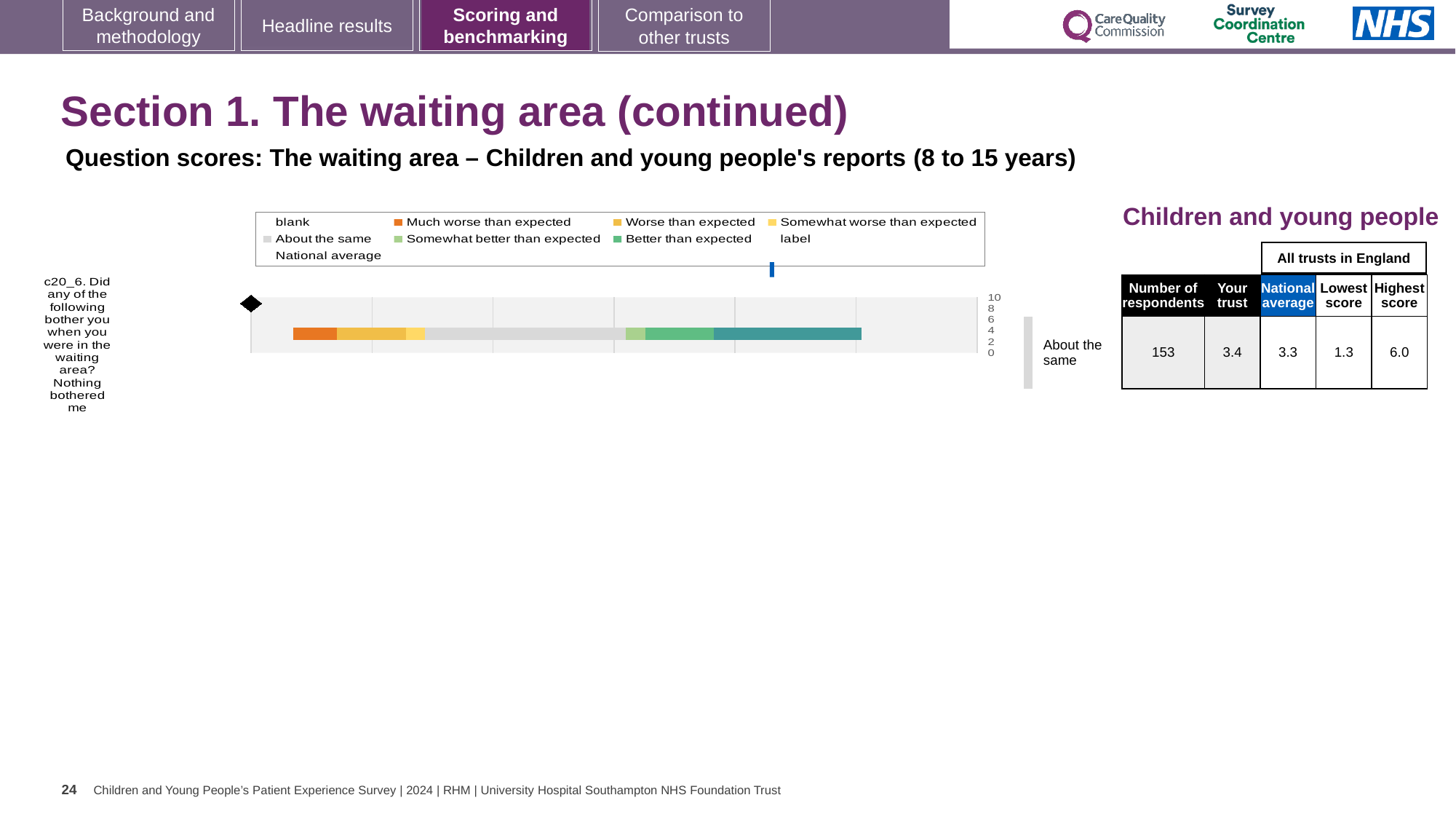
Which question is plotted in the chart? c20_6. Did any of the following bother you when you were in the waiting area? Nothing bothered me What is the 'Your trust' score for question c20_6? 3.4 What benchmark category label is shown next to the bar for question c20_6? About the same Which is larger for question c20_6, the 'Your trust' score or the national average? Your trust How many entries does the chart legend list? 9 What kind of chart is shown on the slide? bar chart How many respondents answered question c20_6? 153 What is the highest score among all trusts in England for question c20_6? 6.0 What is the difference between the highest score and the lowest score for question c20_6? 4.7 How many questions (categories) are plotted in the chart? 1 What is the national average score for question c20_6? 3.3 What is the lowest score among all trusts in England for question c20_6? 1.3